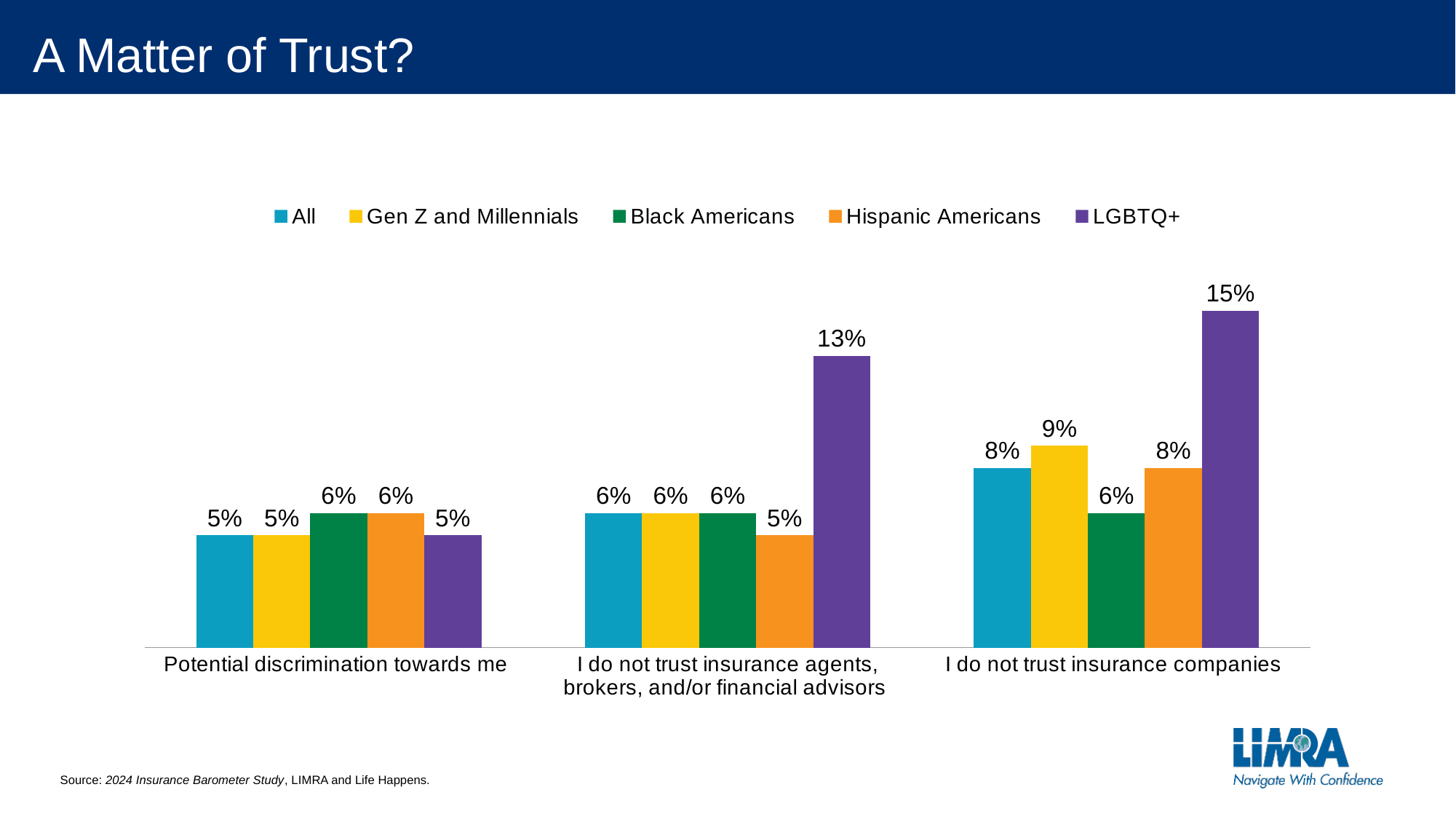
What is the value for LGBTQ+ in the 'I do not trust insurance companies' category? 15% What is the value for Hispanic Americans in the 'I do not trust insurance agents, brokers, and/or financial advisors' category? 5% Do the LGBTQ+ values rise or fall across the categories from left to right? Rise What is the difference between the LGBTQ+ value and the All value in the 'I do not trust insurance companies' category? 7% How many categories are shown on the x axis? 3 What kind of chart is shown on the slide? Bar chart How many series does the legend list? 5 Which series has the lowest value in the 'I do not trust insurance companies' category? Black Americans What is the difference between the LGBTQ+ value and the Hispanic Americans value in the 'I do not trust insurance agents, brokers, and/or financial advisors' category? 8% Which series has the highest value in the 'I do not trust insurance agents, brokers, and/or financial advisors' category? LGBTQ+ Which is larger: the Gen Z and Millennials value or the Black Americans value in the 'I do not trust insurance companies' category? Gen Z and Millennials What is the value for Gen Z and Millennials in the 'I do not trust insurance companies' category? 9%